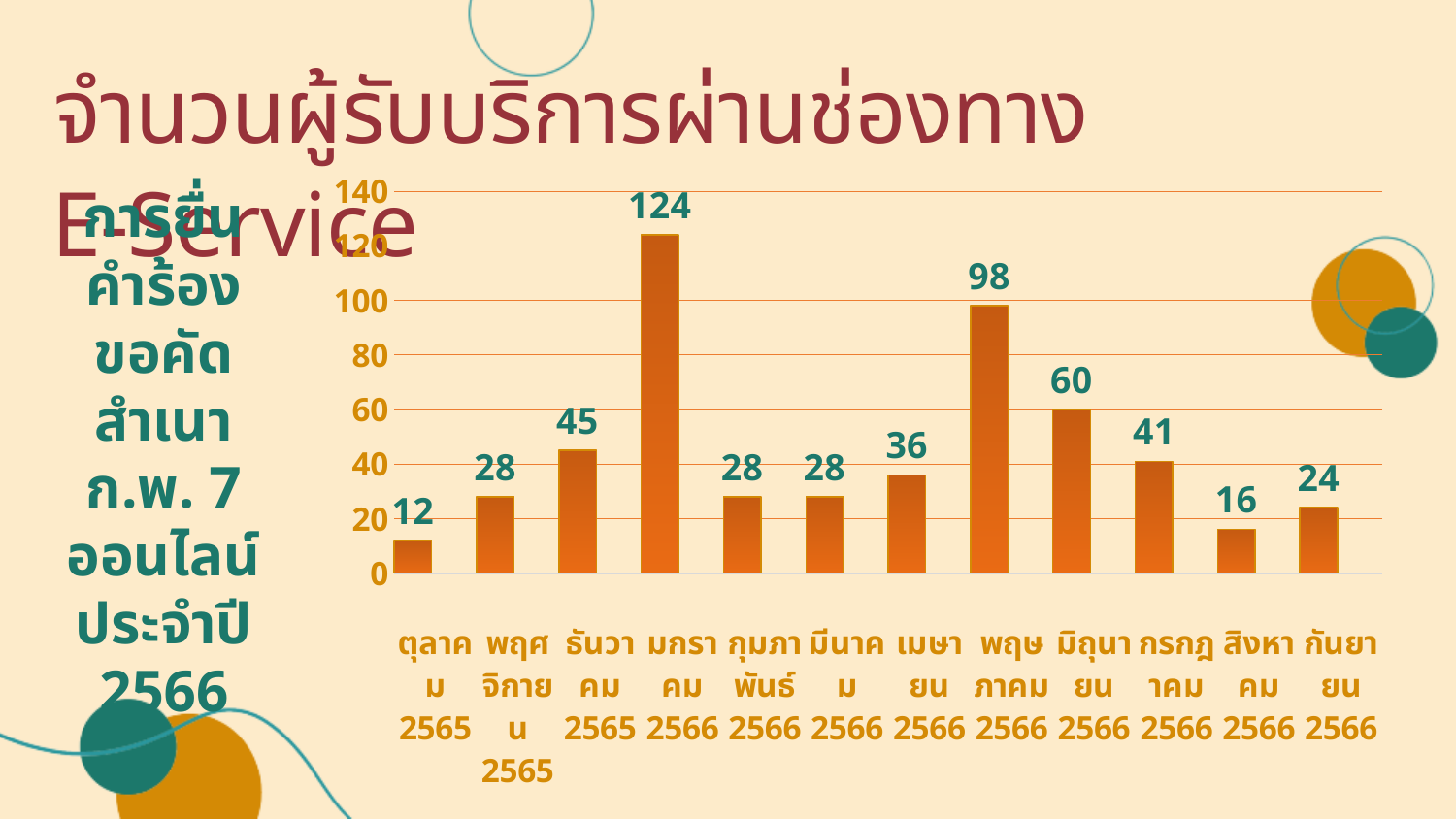
How many months are shown on the chart? 12 Which is larger, the value for มิถุนายน 2566 or the value for กรกฎาคม 2566? มิถุนายน 2566 Which month has the lowest value? ตุลาคม 2565 What is the value for มกราคม 2566? 124 What kind of chart is shown on the slide? bar chart Which month has the highest value? มกราคม 2566 What is the difference between the values for สิงหาคม 2566 and กันยายน 2566? 8 What is the highest value shown on the vertical axis? 140 What is the difference between the values for มกราคม 2566 and พฤษภาคม 2566? 26 Is the value for ธันวาคม 2565 greater or less than 40? greater What is the value for พฤษภาคม 2566? 98 What is the value for ตุลาคม 2565? 12